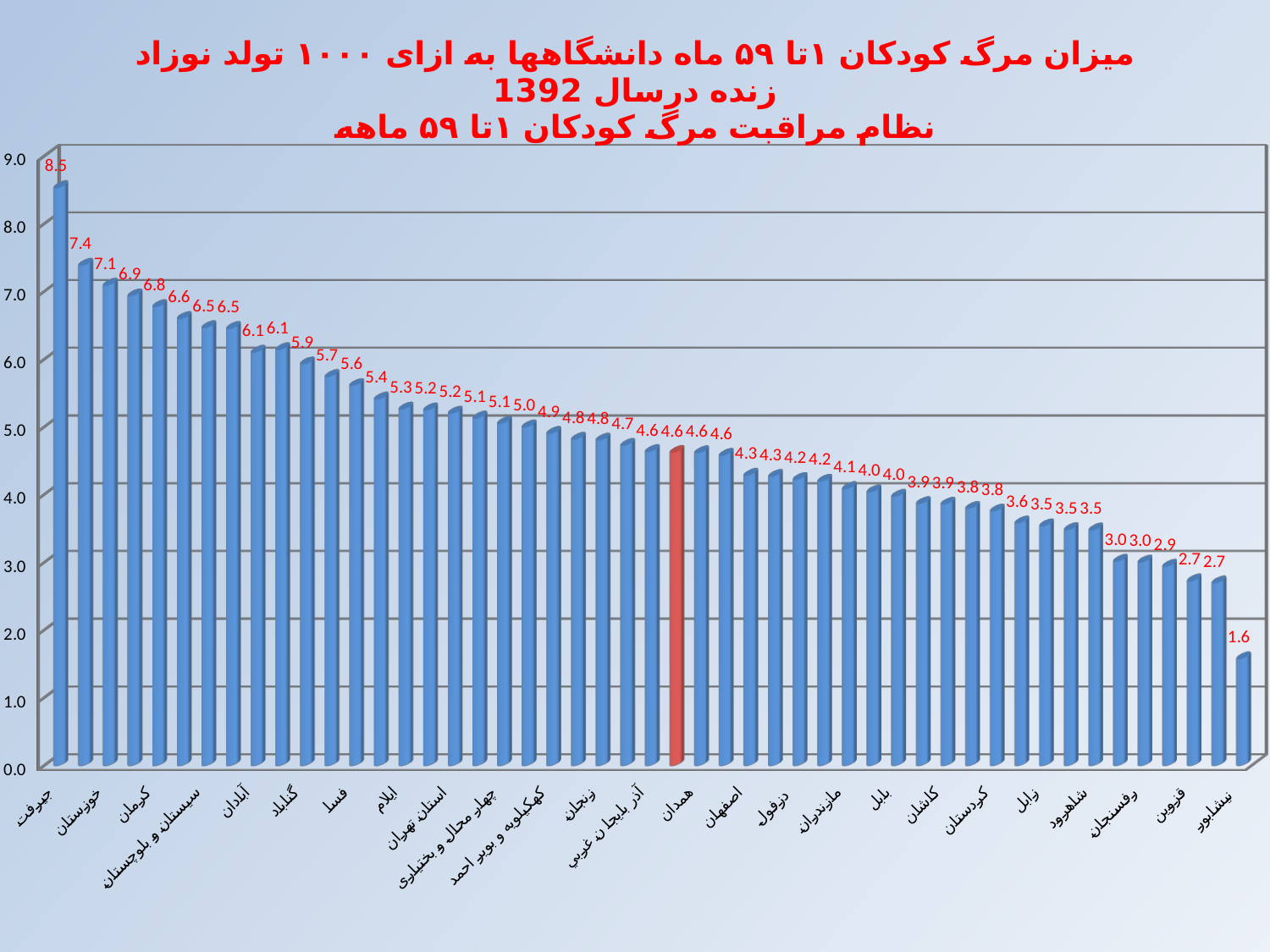
What is the value of the single red bar? 4.6 Do the values rise or fall from left to right along the x axis? fall What is the difference between the values for جیرفت and نیشابور? 6.9 Which category has the highest value? جیرفت What is the value for ایلام? 5.3 Is the value for کرمان greater or less than 6.0? greater What is the value for نیشابور? 1.6 Which is larger, the value for کرمان or the value for اصفهان? کرمان What is the value for جیرفت? 8.5 What is the value for خوزستان? 7.1 What type of chart is shown on the slide? bar chart Which category has the lowest value? نیشابور